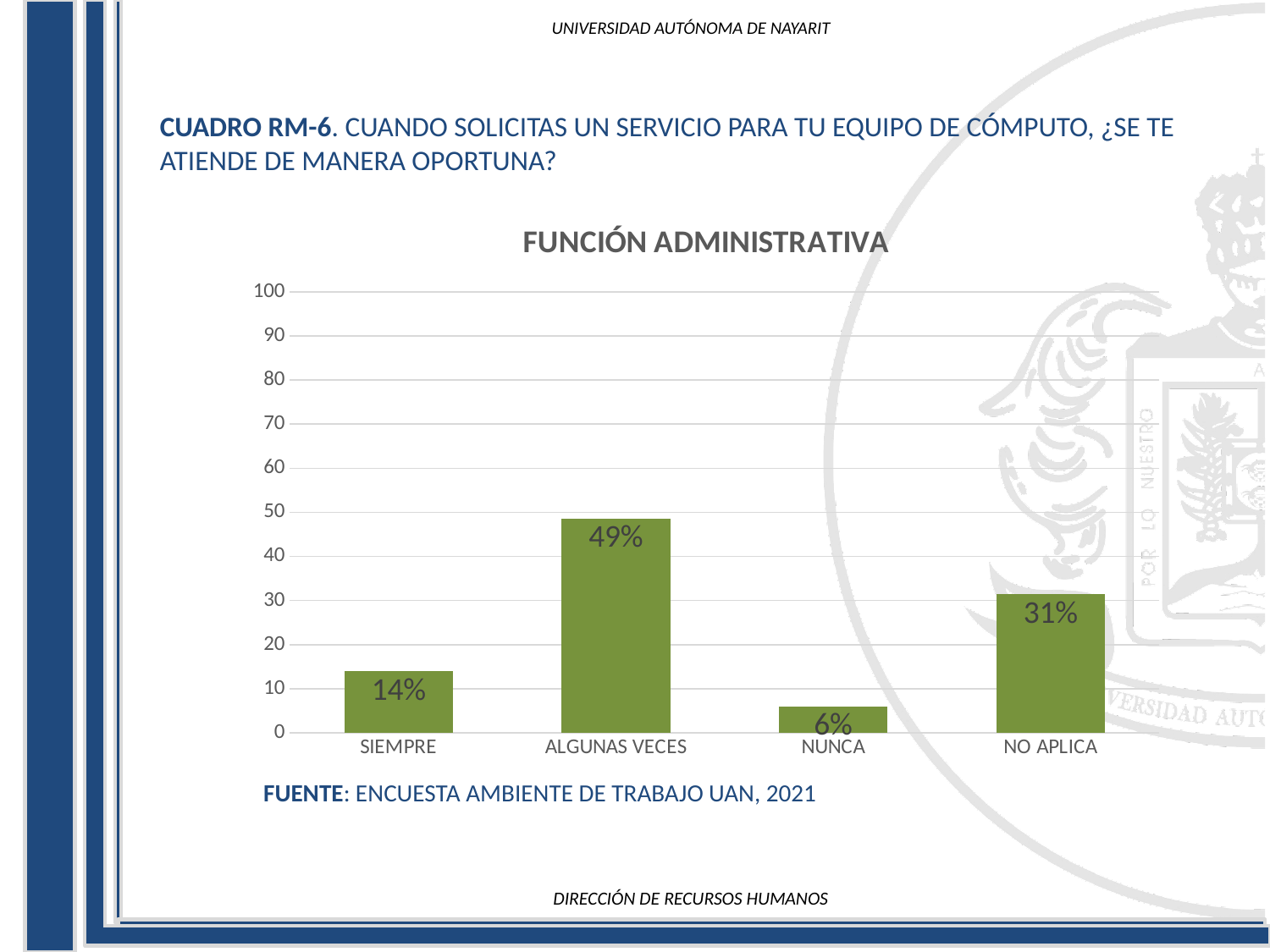
What is the value for ALGUNAS VECES? 49% How many categories are shown on the x axis? 4 Which category has the lowest value? NUNCA Which category has the highest value? ALGUNAS VECES Which is larger, the value for SIEMPRE or the value for NO APLICA? NO APLICA Is the value for NO APLICA greater or less than 40? less What is the value for SIEMPRE? 14% What is the value for NUNCA? 6% What kind of chart is shown on the slide? bar chart What is the difference between the values for ALGUNAS VECES and NO APLICA? 18% What is the value for NO APLICA? 31% What is the title of the chart? FUNCIÓN ADMINISTRATIVA